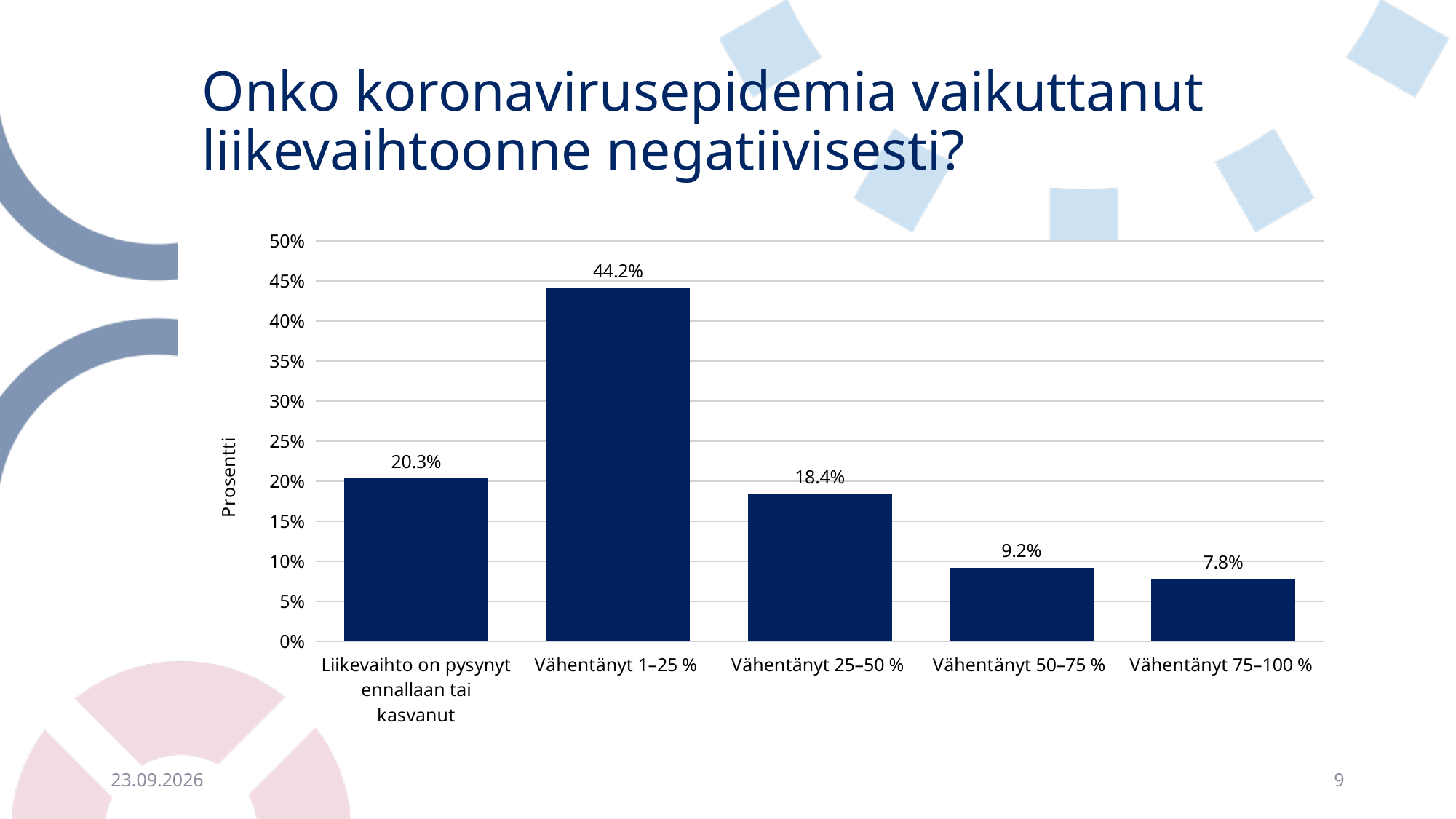
Which category has the highest value? Vähentänyt 1–25 % What is the value for "Vähentänyt 1–25 %"? 44.2% What is the difference between the values for "Vähentänyt 1–25 %" and "Vähentänyt 25–50 %"? 25.8% Which is larger: the value for "Liikevaihto on pysynyt ennallaan tai kasvanut" or the value for "Vähentänyt 25–50 %"? Liikevaihto on pysynyt ennallaan tai kasvanut What is the value for "Vähentänyt 75–100 %"? 7.8% Which category has the lowest value? Vähentänyt 75–100 % What is the value for "Liikevaihto on pysynyt ennallaan tai kasvanut"? 20.3% Is the value for "Vähentänyt 50–75 %" greater or less than 10%? less What is the difference between the values for "Vähentänyt 50–75 %" and "Vähentänyt 75–100 %"? 1.4% What kind of chart is shown on the slide? Bar chart What is the label of the vertical axis? Prosentti How many categories are shown on the x axis? 5